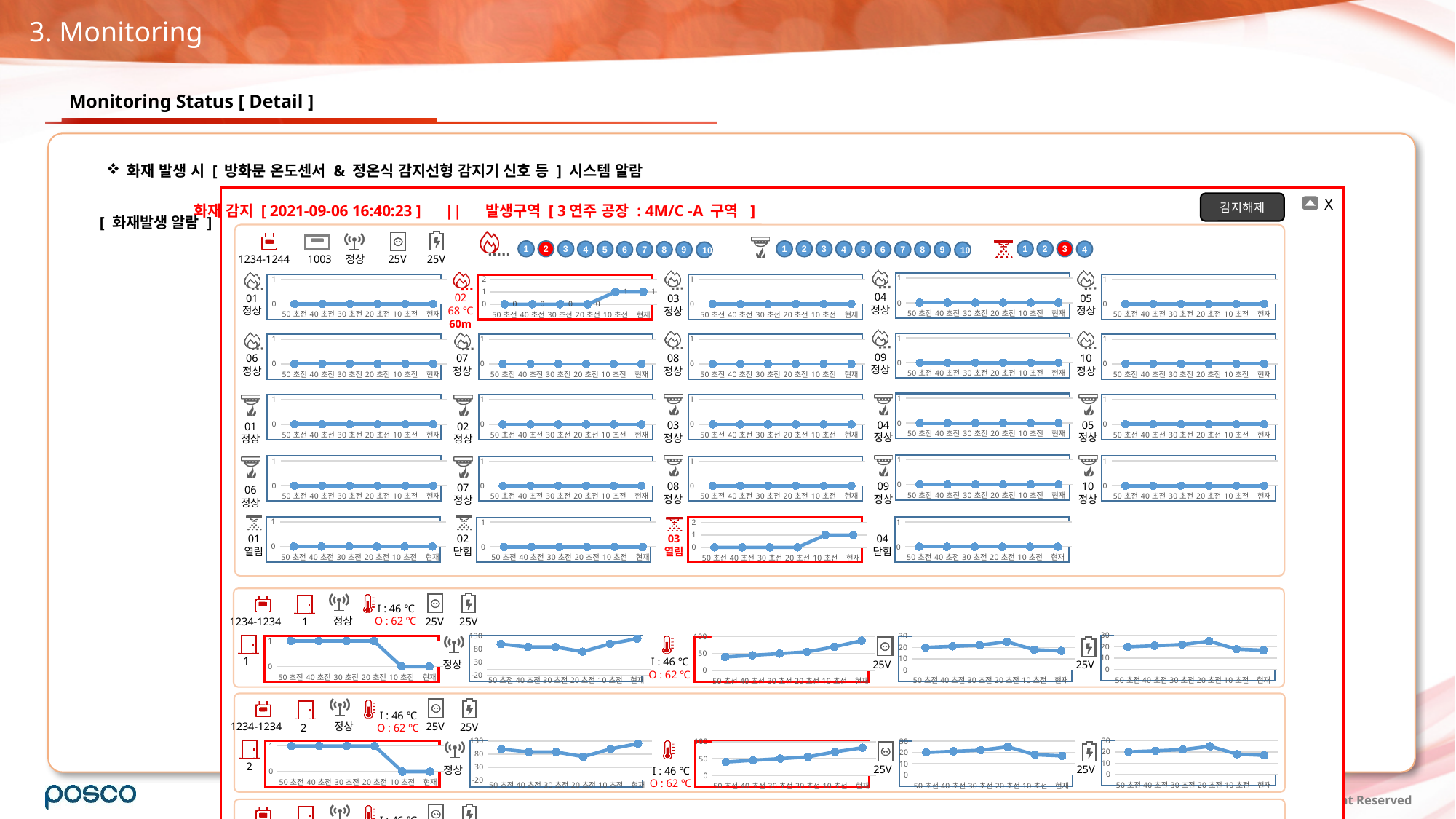
In the red-bordered chart for sprinkler 03 (열림, fifth row), do the values rise or fall from 50 초전 to 현재? rise What date and time is shown in the 화재 감지 alarm header? 2021-09-06 16:40:23 In the red-bordered chart for fire detector 02 (top row), do the values rise or fall from 50 초전 to 현재? rise How many time points are labelled on the x axis of each sensor chart (from 50 초전 to 현재)? 6 What kind of chart is used for each sensor's time-series panel on the slide? line chart In the red-bordered chart for fire detector 02 (top row), what is the value at 현재? 1 In the red-bordered chart for sprinkler 03 (열림, fifth row), what is the value at 현재? 1 In the red-bordered door chart for door 1 (lower section), what is the value at 현재? 0 In the red-bordered door chart for door 1 (lower section), what is the value at 50 초전? 1 In the red-bordered temperature chart for door 1 (lower section, y axis 0 to 100), is the value at 현재 greater or less than 50? greater In the chart for fire detector 01 (정상, top row), do the values rise, fall, or stay flat from 50 초전 to 현재? stay flat In the red-bordered chart for fire detector 02 (top row), what is the value at 50 초전? 0